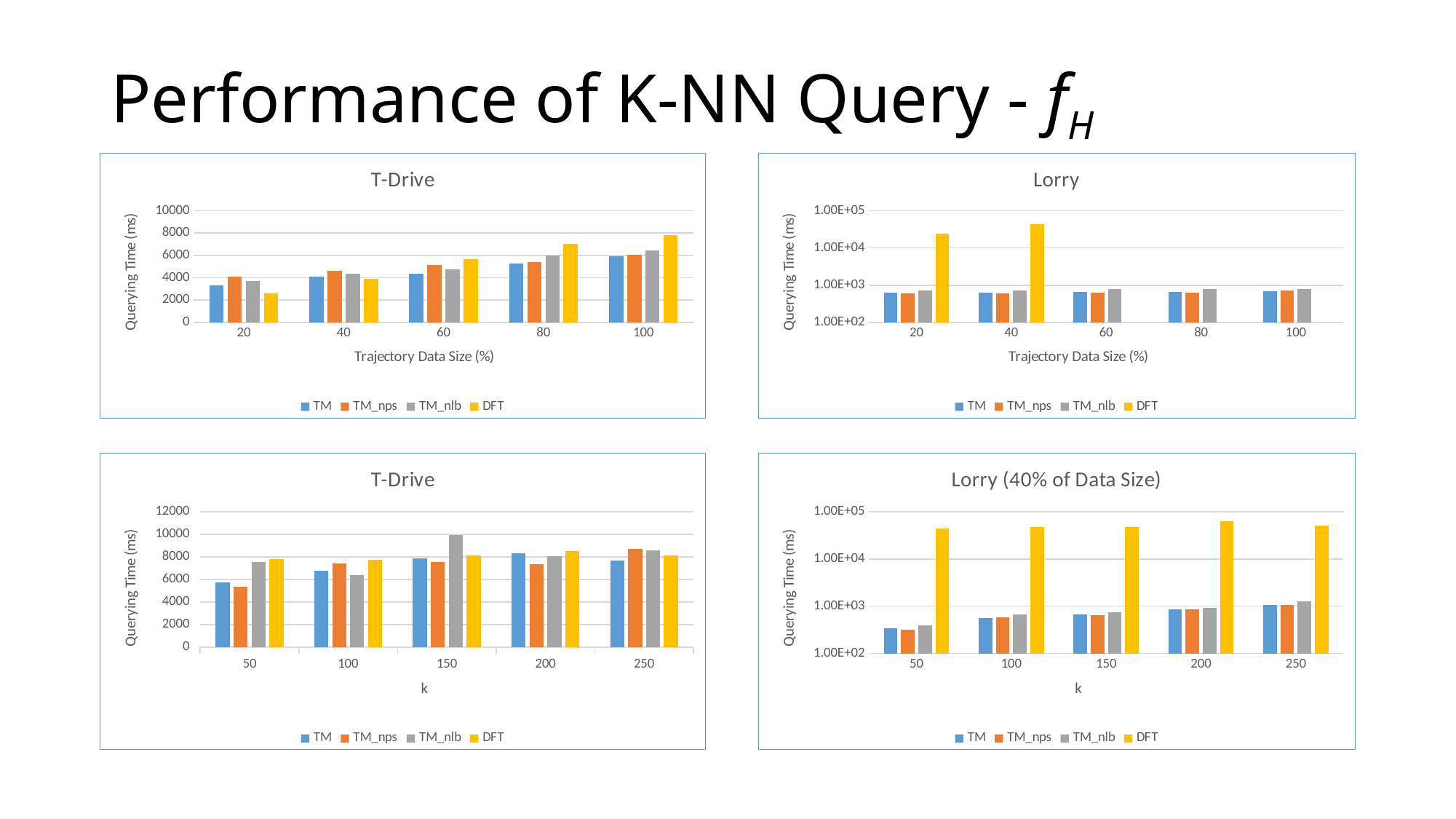
How many k categories are shown on the x axis of the bottom-left T-Drive chart? 5 In the bottom-left T-Drive chart, which is larger at k = 50: TM or TM_nlb? TM_nlb In the bottom-left T-Drive chart, is the value for TM_nlb at k = 150 greater or less than 8000? greater In the bottom-right Lorry (40% of Data Size) chart, is the value for TM at k = 50 greater or less than 1.00E+03? less In the top-left T-Drive chart, is the value for TM at trajectory data size 20 greater or less than 4000? less In the top-left T-Drive chart, which series has the lowest value at trajectory data size 20? DFT How many series does the legend of the bottom-right Lorry (40% of Data Size) chart list? 4 In the top-left T-Drive chart, do the TM values rise or fall as trajectory data size increases from 20 to 100? rise In the top-right Lorry chart, which series has the highest value at trajectory data size 20? DFT In the bottom-left T-Drive chart, which series has the highest value at k = 150? TM_nlb